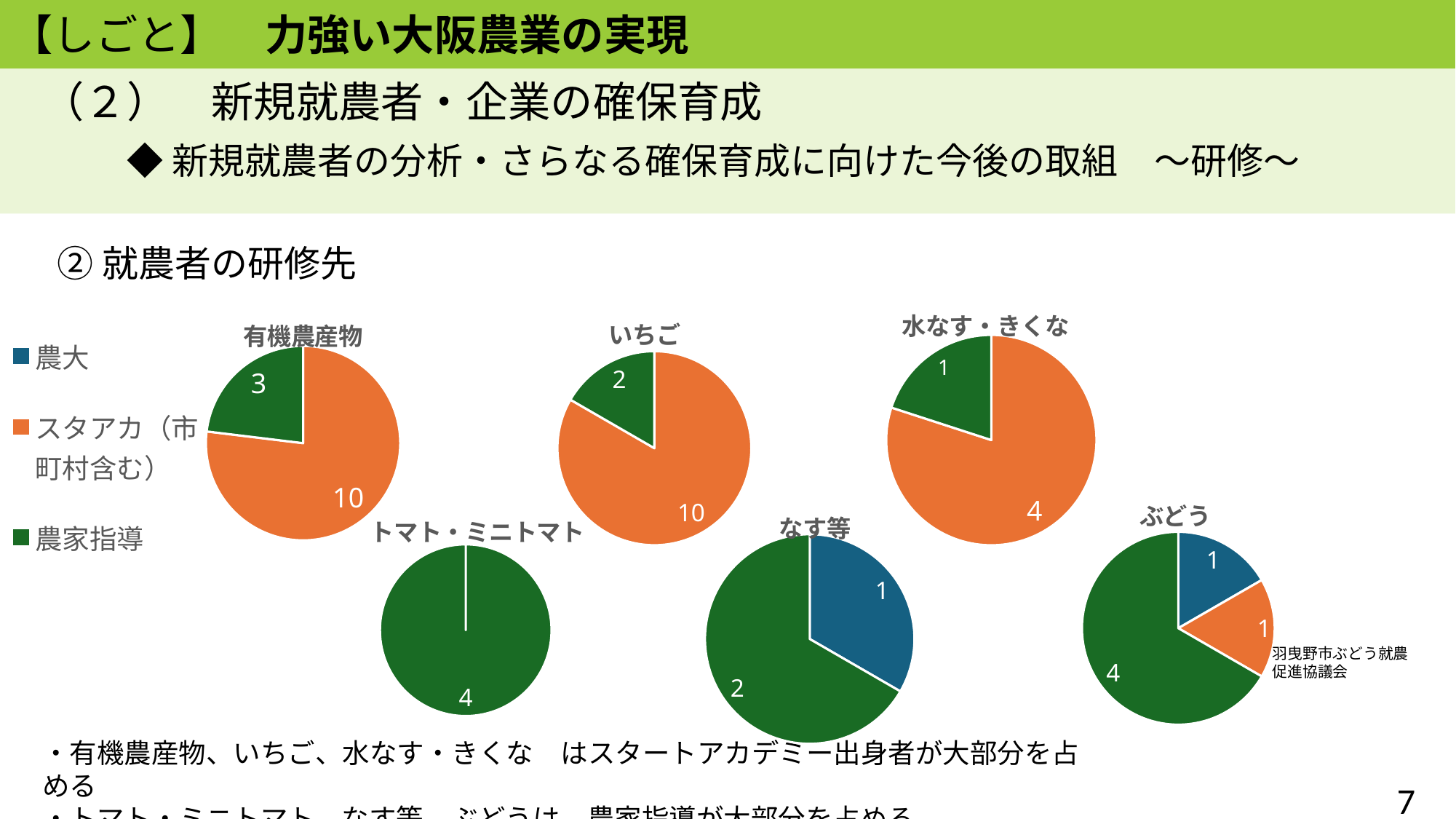
In the いちご pie chart, what is the difference between the スタアカ（市町村含む） value and the 農家指導 value? 8 In the なす等 pie chart, which is larger, 農大 or 農家指導? 農家指導 In the なす等 pie chart, what is the value for 農大? 1 In the 有機農産物 pie chart, what is the value for 農家指導? 3 In the 水なす・きくな pie chart, what is the value for スタアカ（市町村含む）? 4 How many series does the legend list? 3 In the 有機農産物 pie chart, which category is the largest? スタアカ（市町村含む） What kind of chart is the トマト・ミニトマト chart? Pie chart In the ぶどう pie chart, what is the total of all slices? 6 In the ぶどう pie chart, what is the value for 農家指導? 4 In the 有機農産物 pie chart, what is the value for スタアカ（市町村含む）? 10 In the いちご pie chart, what is the value for 農家指導? 2